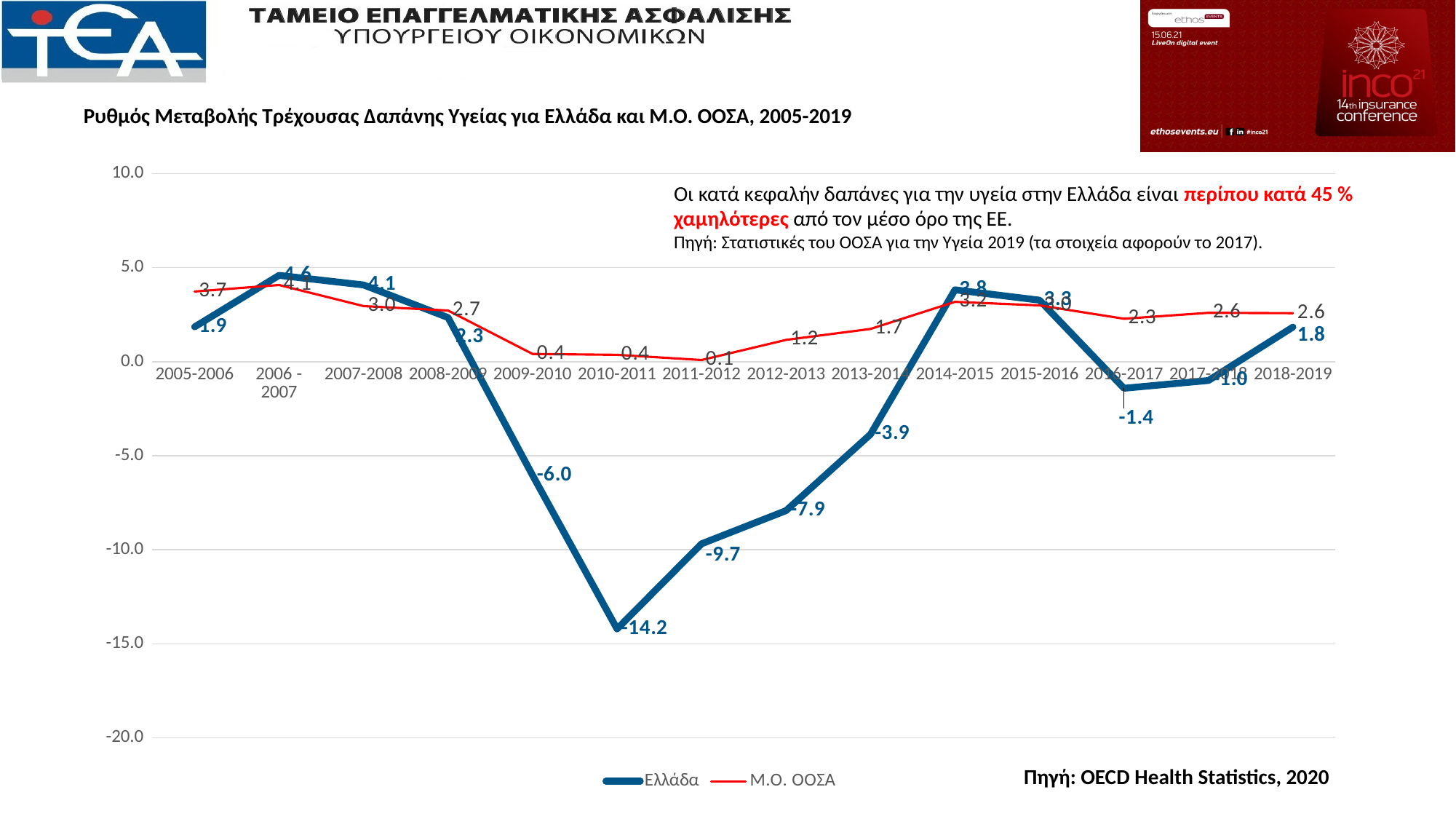
Does the Ελλάδα series rise or fall from 2010-2011 to 2014-2015? Rises How many periods are plotted along the x axis? 14 What is the value for Ελλάδα in 2010-2011? -14.2 How many series does the legend list? 2 In which period does the Ελλάδα series reach its lowest value? 2010-2011 In which period does the Ελλάδα series reach its highest value? 2006-2007 What is the difference between the Μ.Ο. ΟΟΣΑ value and the Ελλάδα value in 2010-2011? 14.6 In which period does the Μ.Ο. ΟΟΣΑ series reach its lowest value? 2011-2012 What is the value for Ελλάδα in 2013-2014? -3.9 What is the value for Μ.Ο. ΟΟΣΑ in 2011-2012? 0.1 What kind of chart is shown on the slide? Line chart In 2009-2010, which series has the higher value, Ελλάδα or Μ.Ο. ΟΟΣΑ? Μ.Ο. ΟΟΣΑ